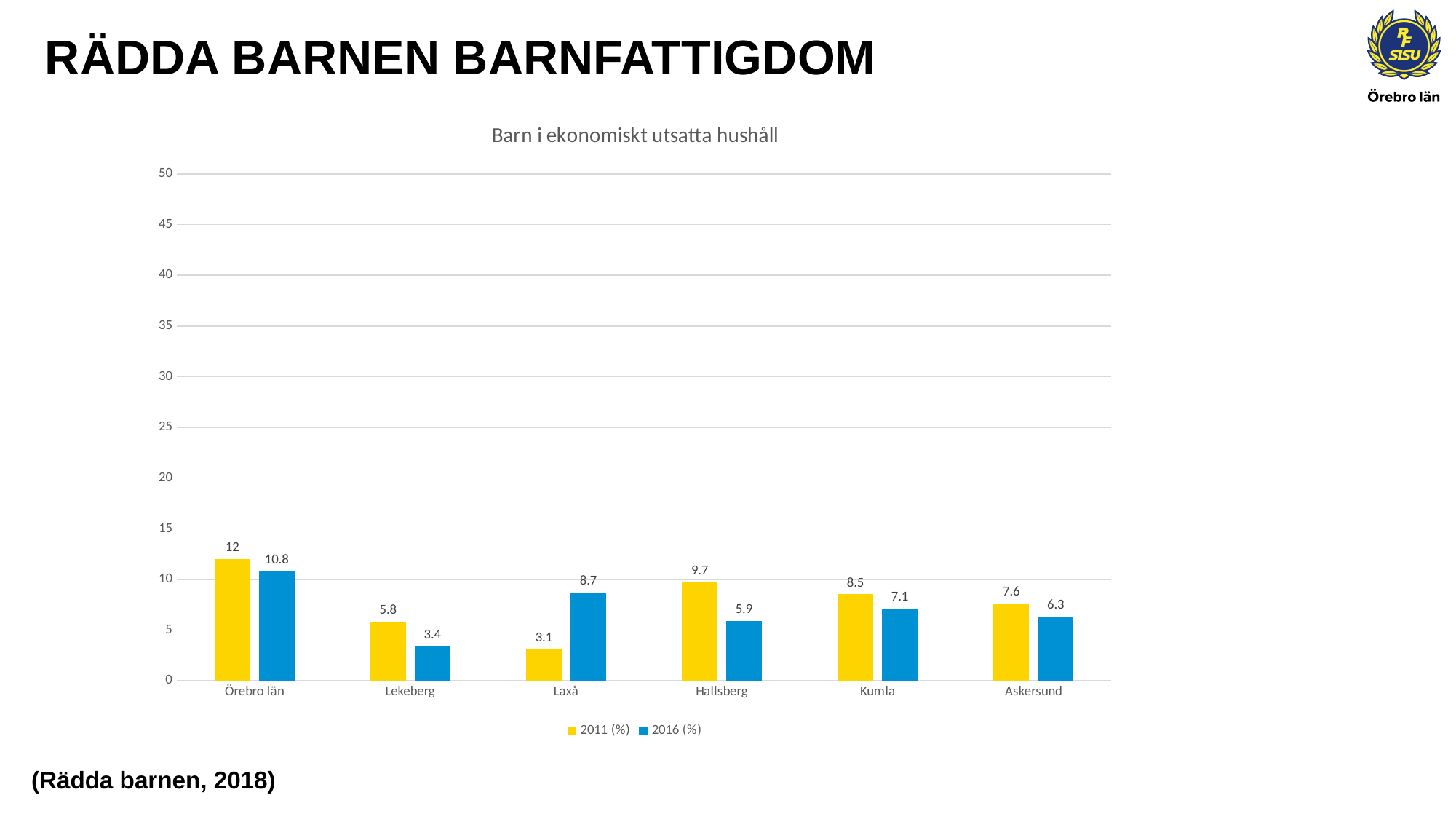
What is the 2011 (%) value for Örebro län? 12 What is the 2016 (%) value for Kumla? 7.1 What kind of chart is shown? bar chart What is the 2016 (%) value for Laxå? 8.7 How many categories are shown on the x axis? 6 Which category has the lowest 2016 (%) value? Lekeberg Is the 2016 (%) value for Askersund greater or less than 10? less Which is larger for Laxå: the 2011 (%) value or the 2016 (%) value? 2016 (%) Which category has the highest 2011 (%) value? Örebro län What is the title of the chart? Barn i ekonomiskt utsatta hushåll What is the difference between the 2011 (%) and 2016 (%) values for Hallsberg? 3.8 How many series does the legend list? 2